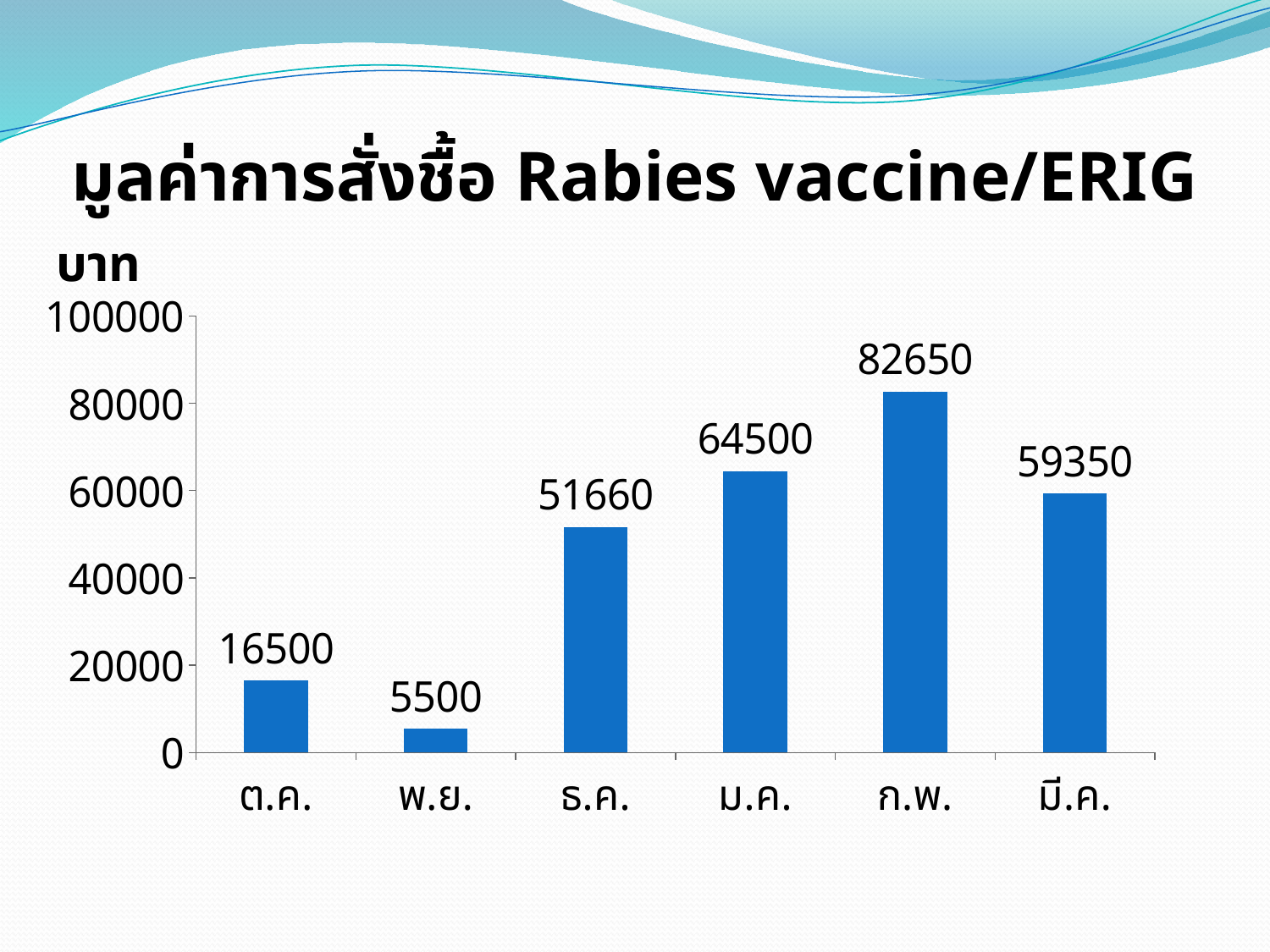
What is the value for มี.ค.? 59350 What is the value for ก.พ.? 82650 What is the difference between the values for ก.พ. and ม.ค.? 18150 Which is larger, the value for ธ.ค. or the value for มี.ค.? มี.ค. Which month has the highest value? ก.พ. Which month has the lowest value? พ.ย. How many months are shown on the x axis? 6 Is the value for ม.ค. greater or less than 60000? greater What kind of chart is shown on the slide? bar chart What is the value for ต.ค.? 16500 What unit label is shown above the y axis? บาท What is the value for พ.ย.? 5500